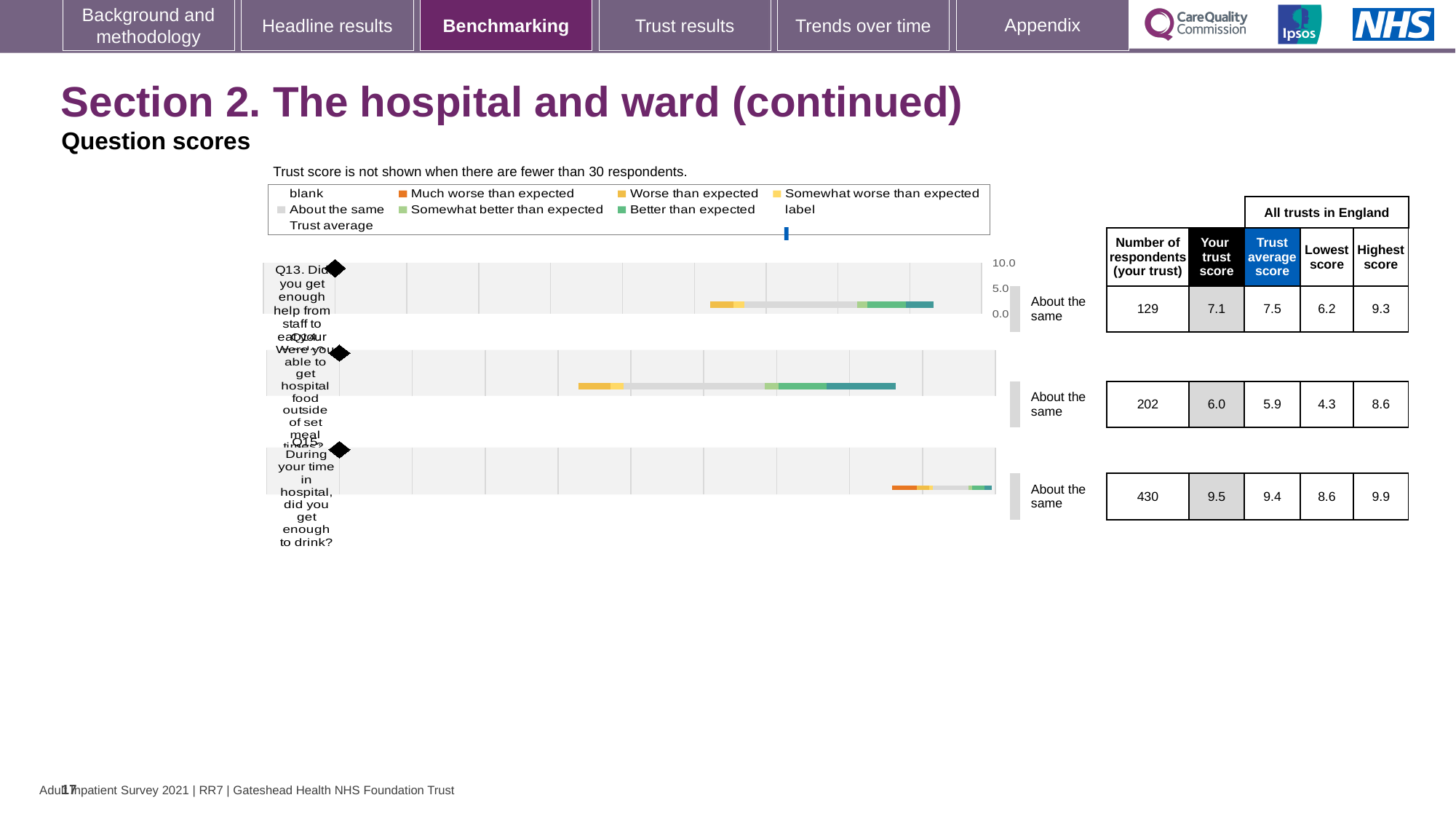
What benchmark category is shown next to Q14? About the same How many respondents answered Q15 (During your time in hospital, did you get enough to drink?) at this trust? 430 How many questions are shown in the chart on this slide? 3 Which question has the fewest respondents at this trust? Q13 What is the highest score across all trusts in England for Q14 (Were you able to get hospital food outside of set meal times?)? 8.6 What is the trust average score for Q15? 9.4 Which question has the highest 'Your trust score'? Q15 What is the 'Your trust score' for Q13 (Did you get enough help from staff to eat your meals?)? 7.1 Is the trust score for Q14 greater or less than 5.0? greater For Q13, which is larger: the trust's own score or the trust average score? Trust average score (7.5) What is the difference between the highest score and the lowest score for Q14? 4.3 What type of chart is used to show the question scores? Bar chart